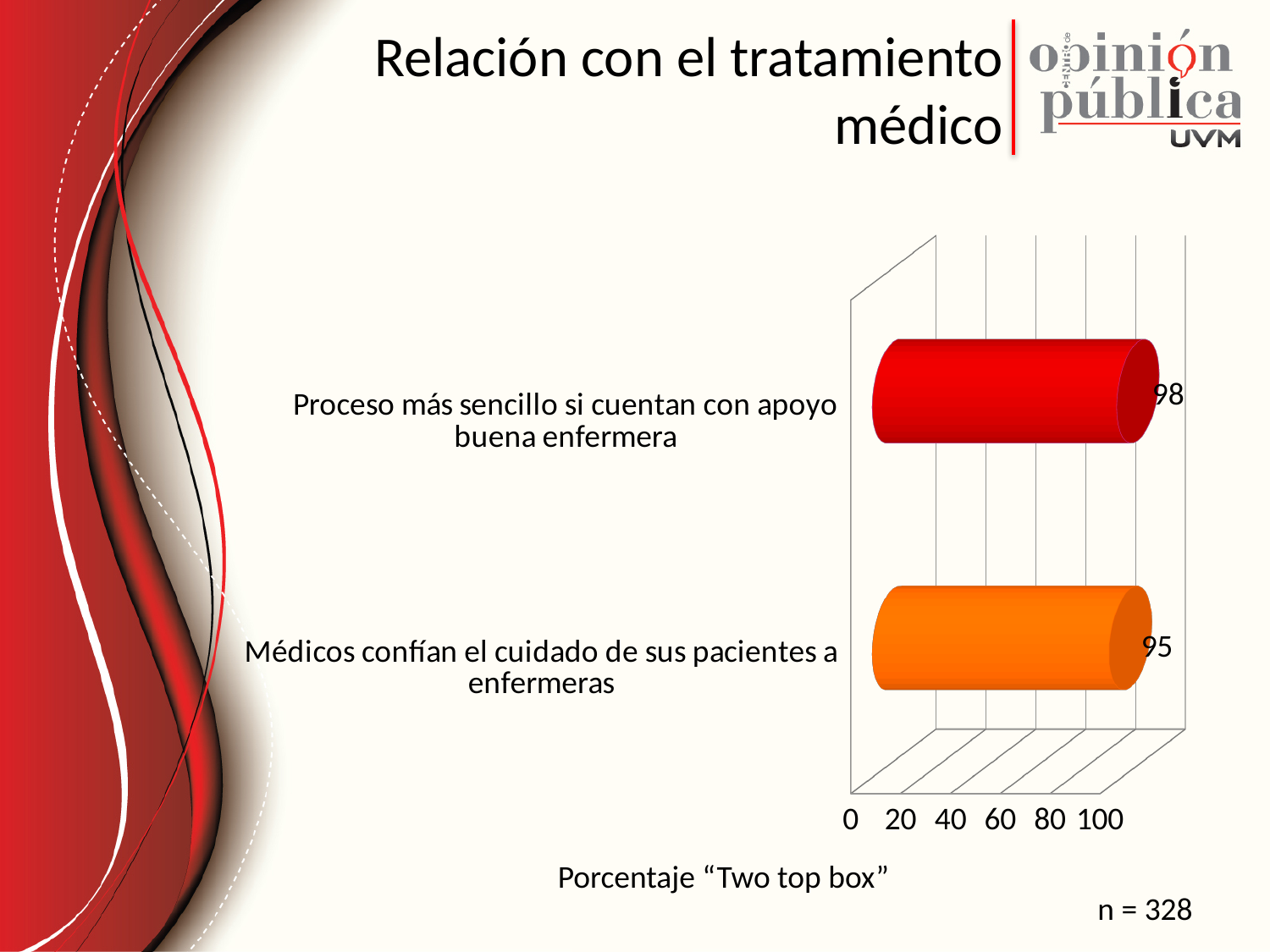
What kind of chart is shown on the slide? bar chart What is the value for "Proceso más sencillo si cuentan con apoyo buena enfermera"? 98 Which category has the highest value? Proceso más sencillo si cuentan con apoyo buena enfermera What is the value for "Médicos confían el cuidado de sus pacientes a enfermeras"? 95 What is the sample size (n) noted on the slide? n = 328 Which is larger: the value for "Proceso más sencillo si cuentan con apoyo buena enfermera" or for "Médicos confían el cuidado de sus pacientes a enfermeras"? Proceso más sencillo si cuentan con apoyo buena enfermera Is the value for "Médicos confían el cuidado de sus pacientes a enfermeras" greater or less than 80? greater What is the difference between the values for "Proceso más sencillo si cuentan con apoyo buena enfermera" and "Médicos confían el cuidado de sus pacientes a enfermeras"? 3 Which category has the lowest value? Médicos confían el cuidado de sus pacientes a enfermeras What is the title of the slide containing the chart? Relación con el tratamiento médico How many categories are shown in the chart? 2